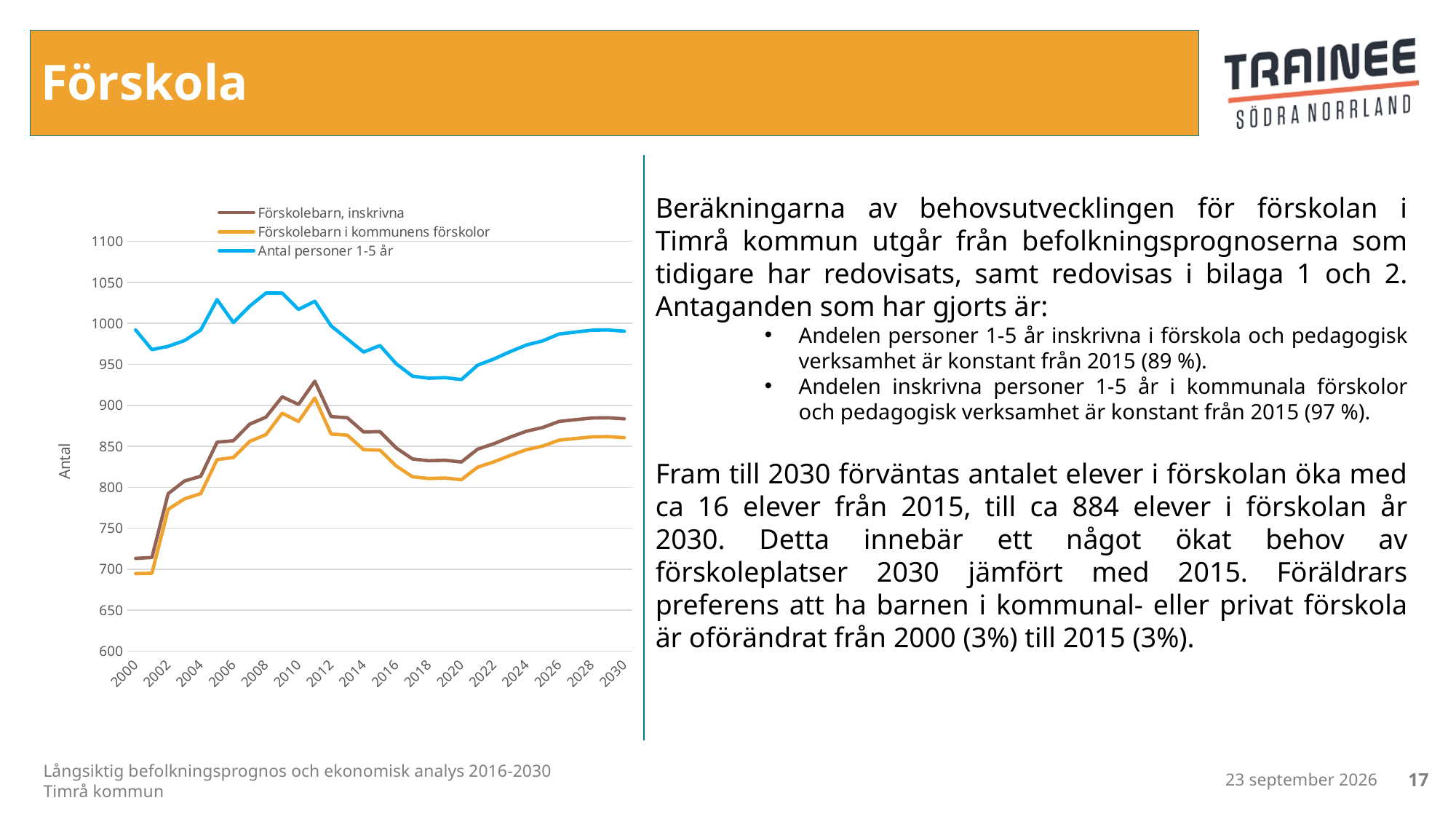
What is the label on the chart's vertical axis? Antal Is the value for Förskolebarn i kommunens förskolor in 2030 greater or less than 900? less Is the value for Förskolebarn, inskrivna in 2000 greater or less than 750? less Does the Förskolebarn, inskrivna series rise or fall between 2000 and 2011? rise What kind of chart is shown on the slide? line chart Does the Antal personer 1-5 år series rise or fall between 2020 and 2030? rise Is the value for Antal personer 1-5 år in 2000 greater or less than 950? greater In 2011, which series has the higher value: Antal personer 1-5 år or Förskolebarn, inskrivna? Antal personer 1-5 år How many series does the chart's legend list? 3 In which year does the Förskolebarn, inskrivna series reach its highest value? 2011 What are the three series named in the chart's legend? Förskolebarn, inskrivna; Förskolebarn i kommunens förskolor; Antal personer 1-5 år